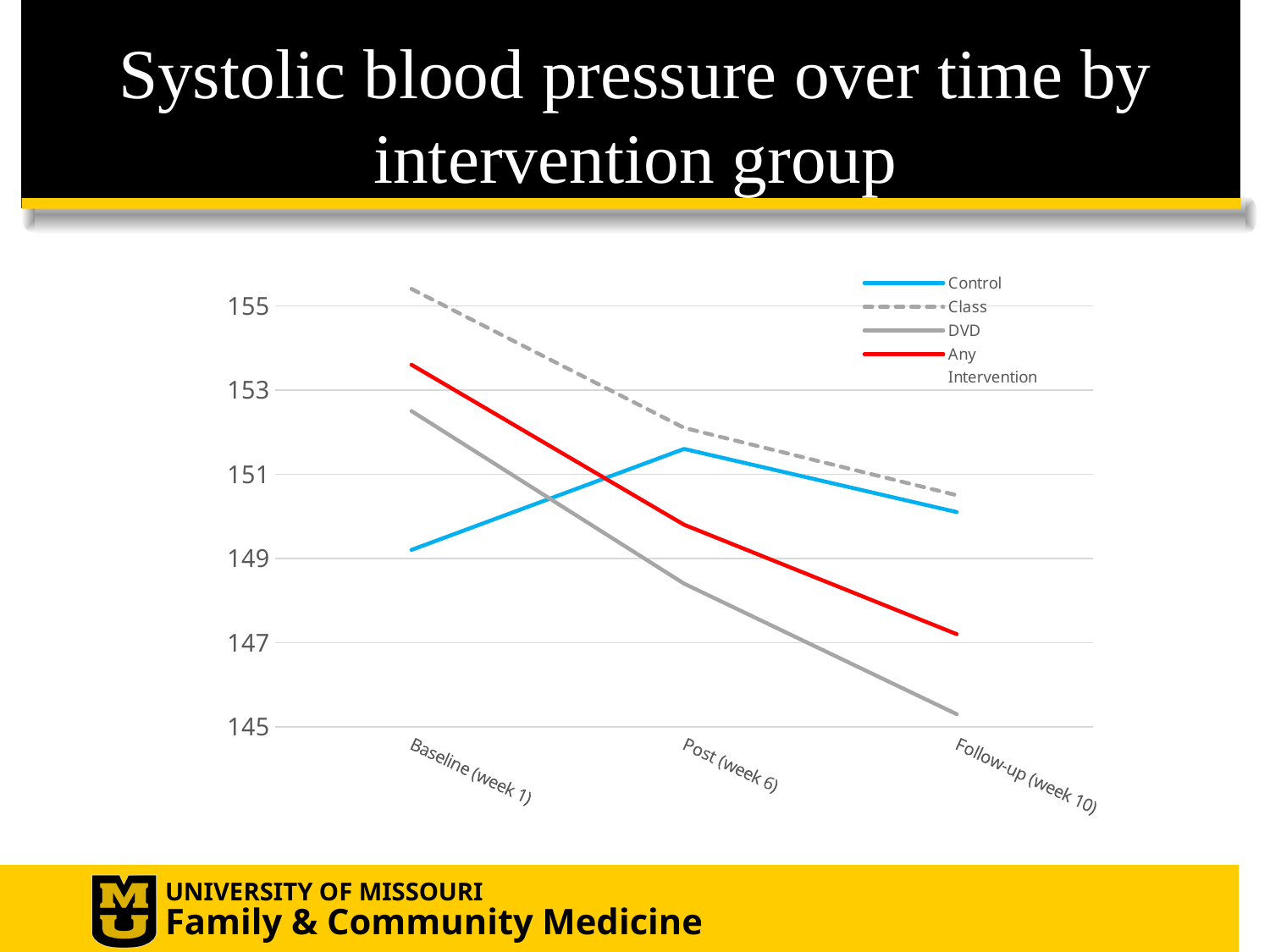
Is the value for Any Intervention at Follow-up (week 10) greater or less than 149? less How many series does the legend list? 4 How many time points are plotted along the x axis? 3 What is the title of the chart on the slide? Systolic blood pressure over time by intervention group Is the value for DVD at Follow-up (week 10) greater or less than 147? less Which group has the lowest systolic blood pressure at Follow-up (week 10)? DVD Which group has the highest systolic blood pressure at Baseline (week 1)? Class Is the value for Class at Baseline (week 1) greater or less than 153? greater What kind of chart is shown on the slide? line chart Does the DVD line rise or fall from Baseline (week 1) to Follow-up (week 10)? fall At Follow-up (week 10), which is higher: Control or Any Intervention? Control